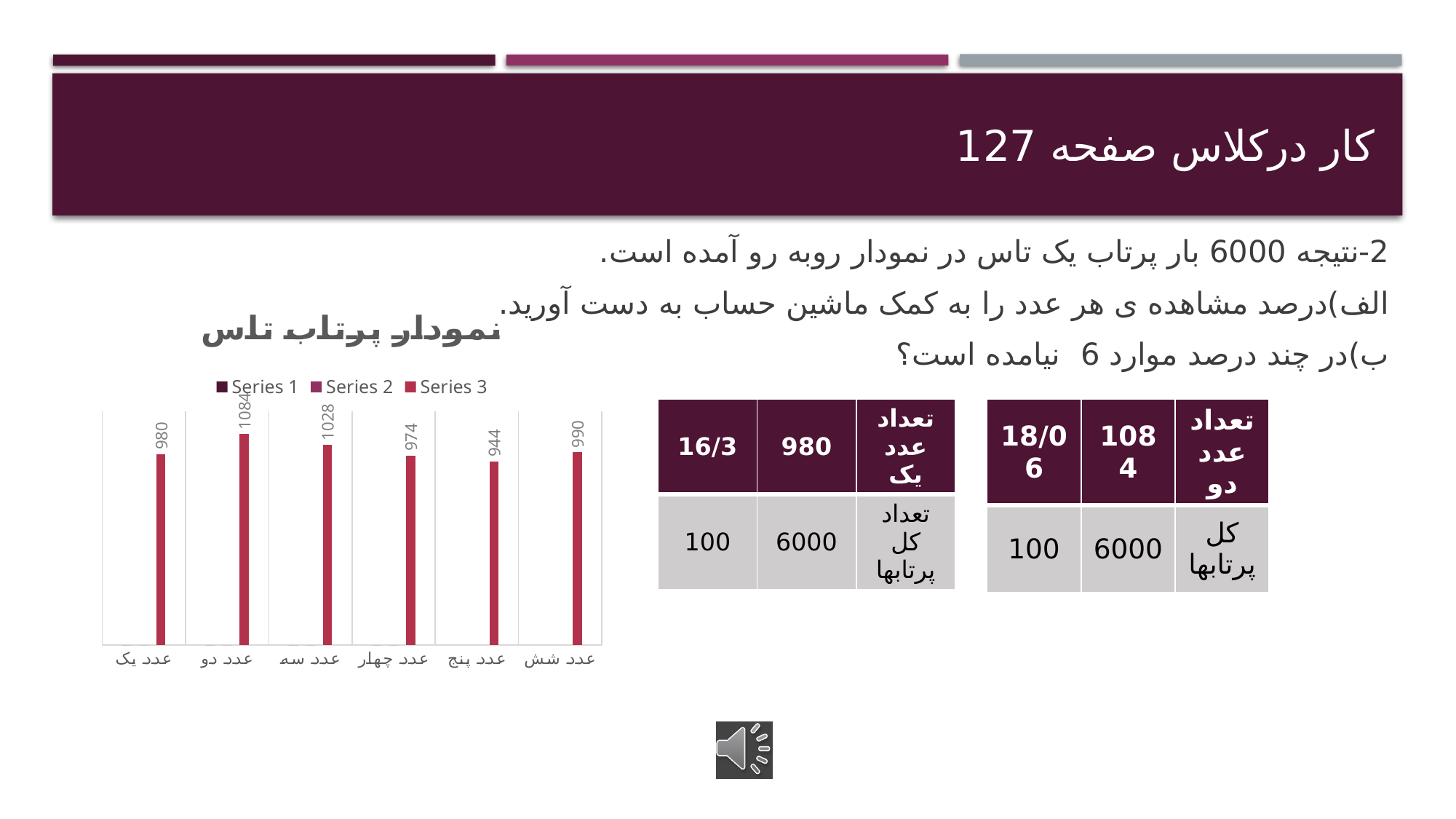
What is the difference between the values for عدد دو and عدد پنج? 140 What is the value for عدد دو in the chart? 1084 What kind of chart is shown on the slide? bar chart What is the value for عدد یک in the chart? 980 How many series does the chart legend list? 3 What is the value for عدد پنج in the chart? 944 Which category has the lowest value in the chart? عدد پنج Which category has the highest value in the chart? عدد دو Which is larger, the value for عدد سه or the value for عدد شش? عدد سه What is the difference between the values for عدد سه and عدد چهار? 54 How many categories are shown on the x axis of the chart? 6 What is the title of the chart? نمودار پرتاب تاس